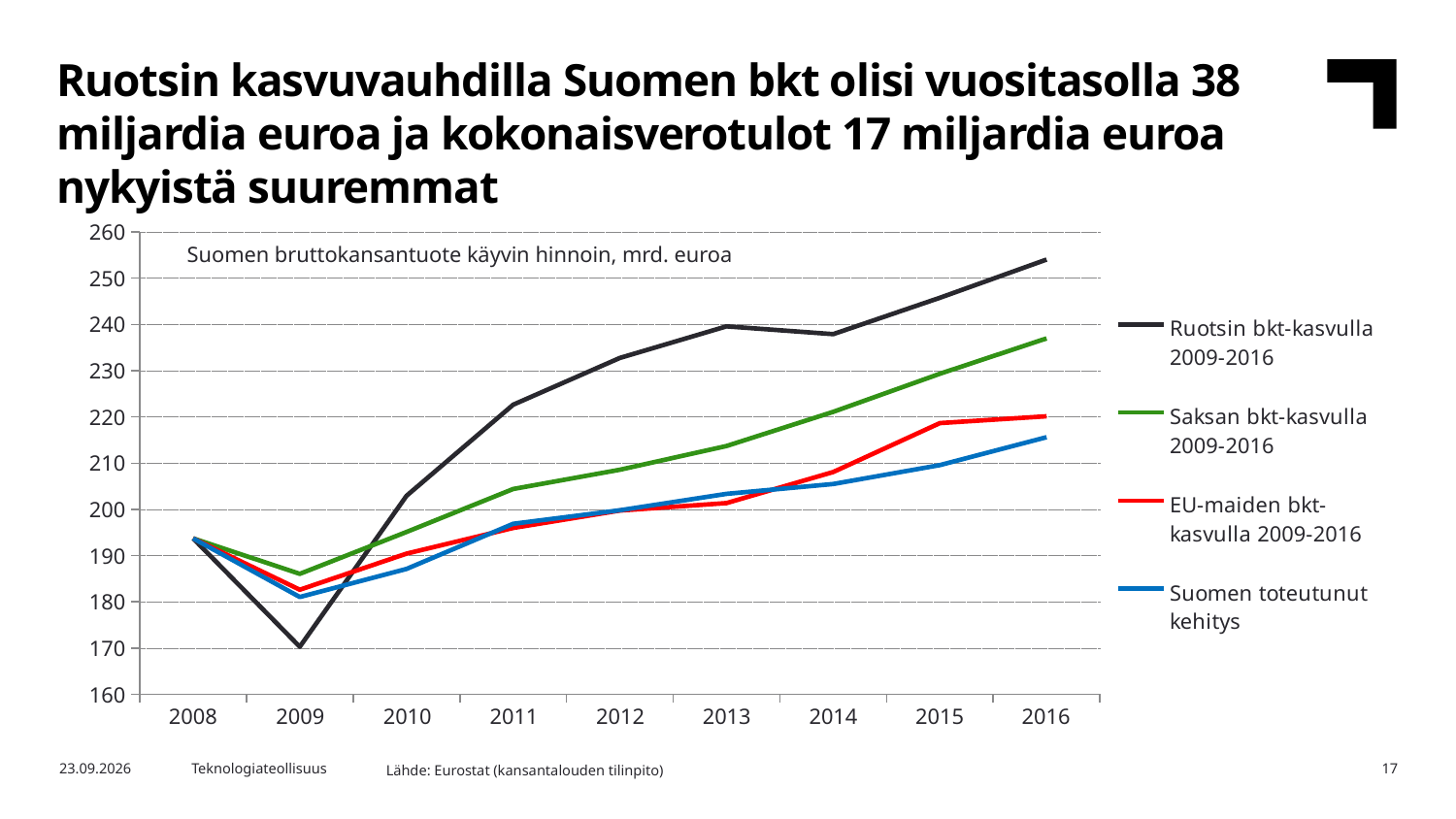
What kind of chart is shown on the slide? line chart Is the value for 'Suomen toteutunut kehitys' in 2016 greater or less than 220? less Is the value for 'Ruotsin bkt-kasvulla 2009-2016' in 2016 greater or less than 250? greater In 2016, which is larger: 'Ruotsin bkt-kasvulla 2009-2016' or 'Saksan bkt-kasvulla 2009-2016'? Ruotsin bkt-kasvulla 2009-2016 What is the text shown inside the plot area describing the chart? Suomen bruttokansantuote käyvin hinnoin, mrd. euroa Is the value for 'Ruotsin bkt-kasvulla 2009-2016' in 2009 greater or less than 180? less In which year does the 'Ruotsin bkt-kasvulla 2009-2016' series reach its lowest value? 2009 How many years are shown on the x axis? 9 Which series has the lowest value in 2016? Suomen toteutunut kehitys How many series does the legend list? 4 Which series has the highest value in 2016? Ruotsin bkt-kasvulla 2009-2016